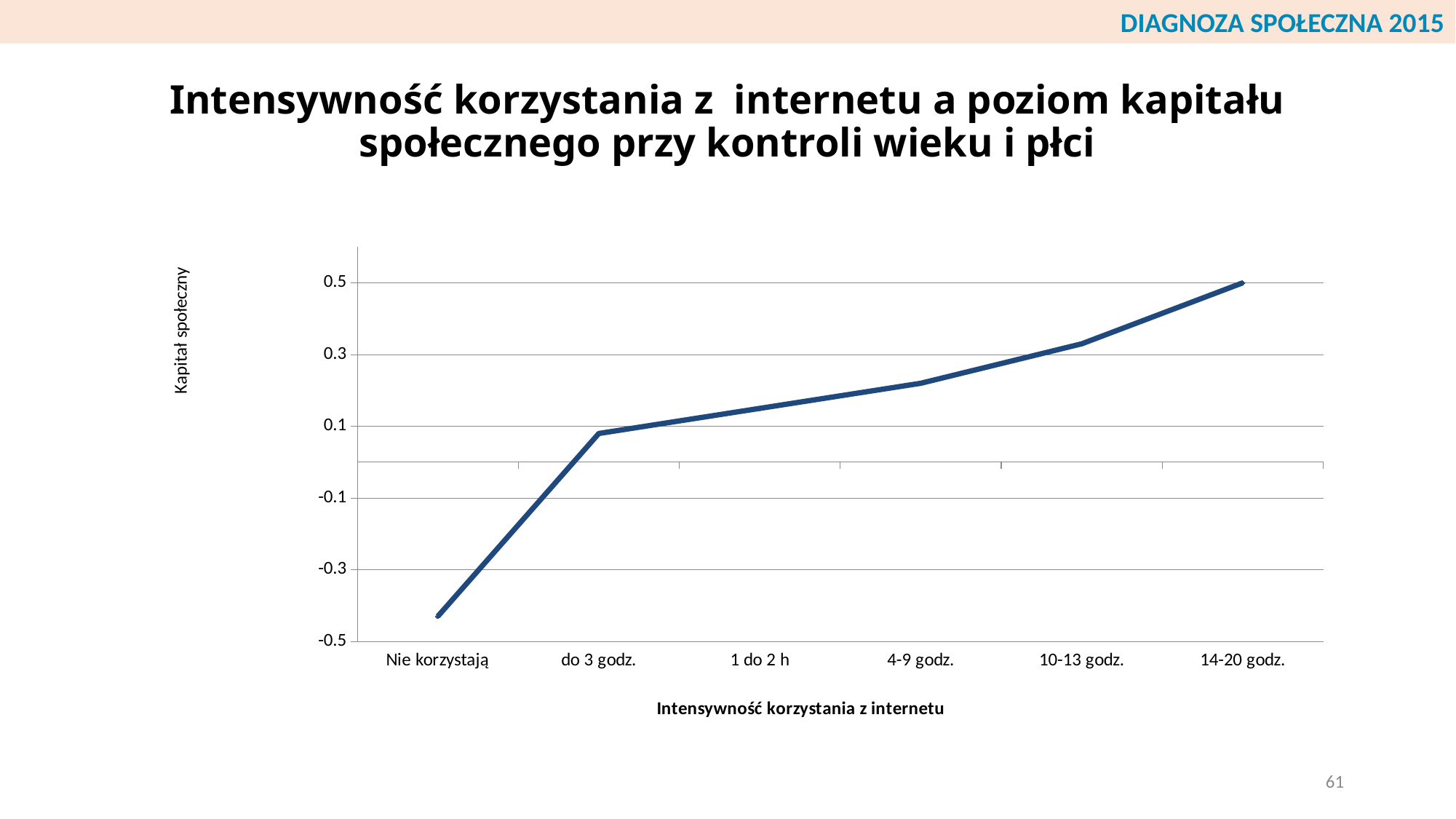
Which category has the highest value of Kapitał społeczny? 14-20 godz. What kind of chart is shown on the slide? line chart Is the value for 10-13 godz. greater or less than 0.3? greater Which has a larger value: 4-9 godz. or do 3 godz.? 4-9 godz. Is the value for Nie korzystają greater or less than -0.3? less Is the value for do 3 godz. greater or less than 0.1? less How many categories are shown on the x axis? 6 Do the values rise or fall along the x axis from Nie korzystają to 14-20 godz.? rise What is the title of the y axis? Kapitał społeczny What is the title of the x axis? Intensywność korzystania z internetu Which category has the lowest value of Kapitał społeczny? Nie korzystają